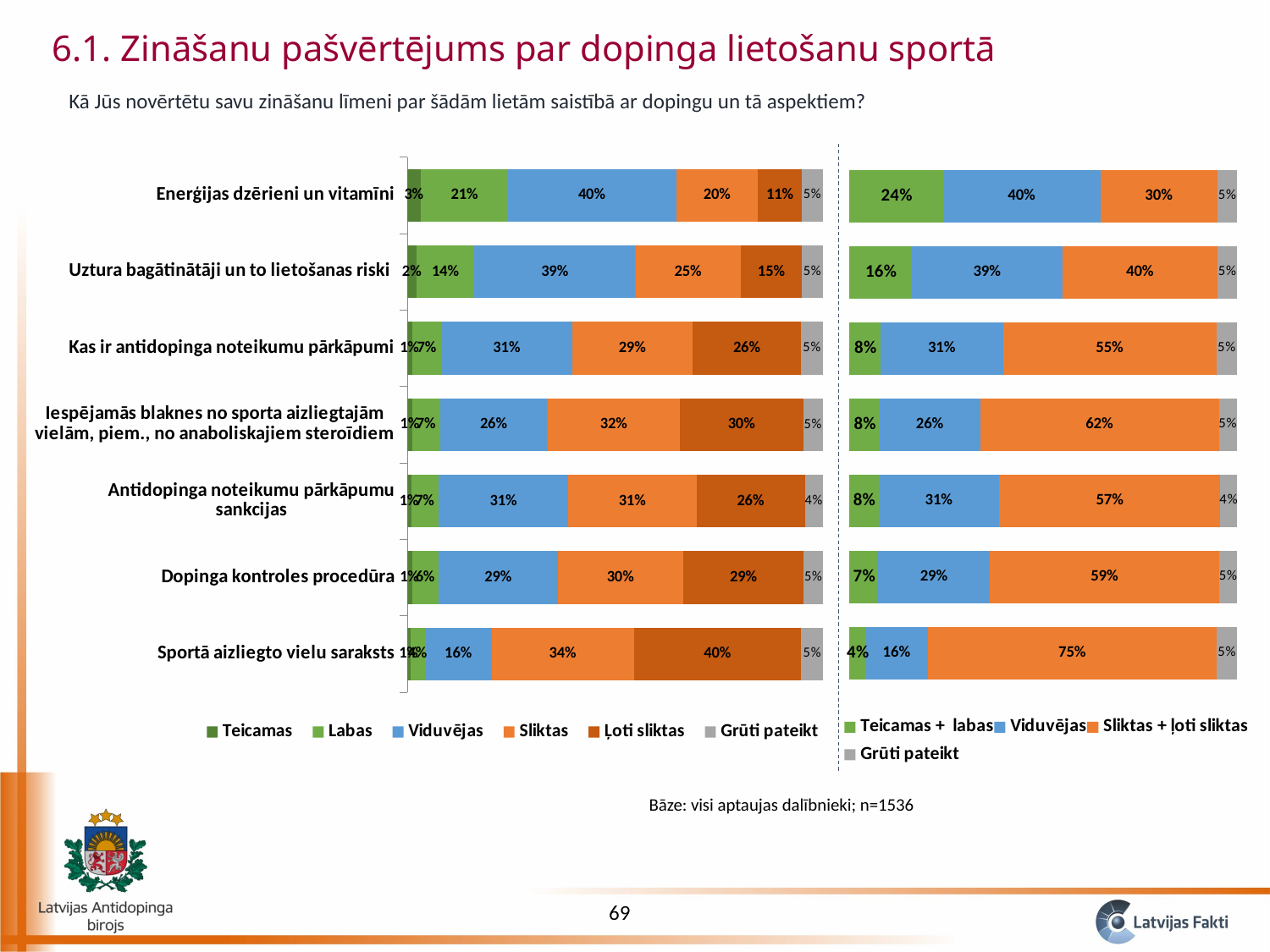
In the right chart, what is the difference between the 'Sliktas + ļoti sliktas' values for 'Sportā aizliegto vielu saraksts' and 'Enerģijas dzērieni un vitamīni'? 45 percentage points In the left chart, what is the 'Viduvējas' value for 'Enerģijas dzērieni un vitamīni'? 40% In the right chart, what is the 'Sliktas + ļoti sliktas' value for 'Sportā aizliegto vielu saraksts'? 75% In the right chart, which category has the highest 'Sliktas + ļoti sliktas' value? Sportā aizliegto vielu saraksts How many series does the legend of the right chart list? 4 In the right chart, which category has the highest 'Teicamas + labas' value? Enerģijas dzērieni un vitamīni In the left chart, what is the 'Ļoti sliktas' value for 'Uztura bagātinātāji un to lietošanas riski'? 15% How many categories are plotted in the right chart? 7 How many series does the legend of the left chart list? 6 In the left chart, which has the larger 'Ļoti sliktas' value: 'Dopinga kontroles procedūra' or 'Kas ir antidopinga noteikumu pārkāpumi'? Dopinga kontroles procedūra In the right chart, which legend entry is shown in grey? Grūti pateikt What kind of chart is the left chart on the slide? Bar chart